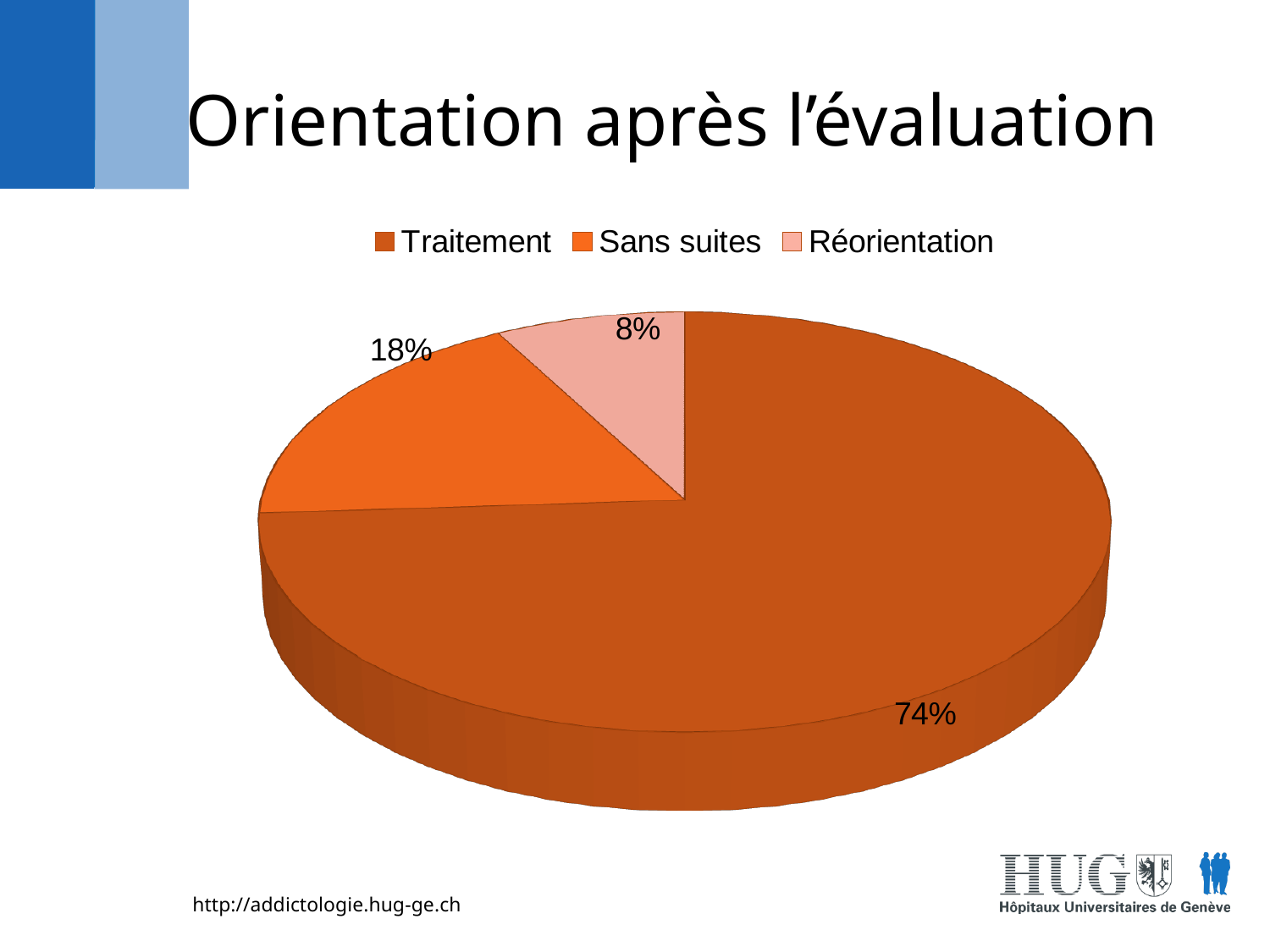
What kind of chart is shown on the slide? pie chart What share of the pie does Réorientation represent? 8% Which category has the smallest slice of the pie? Réorientation What is the difference in percentage points between Sans suites and Réorientation? 10 What is the title of the chart on the slide? Orientation après l'évaluation What share of the pie does Sans suites represent? 18% Which category has the largest slice of the pie? Traitement What share of the pie does Traitement represent? 74% How many entries does the legend list? 3 Which is larger, the share for Sans suites or the share for Réorientation? Sans suites How many slices does the pie chart have? 3 What is the difference in percentage points between Traitement and Sans suites? 56